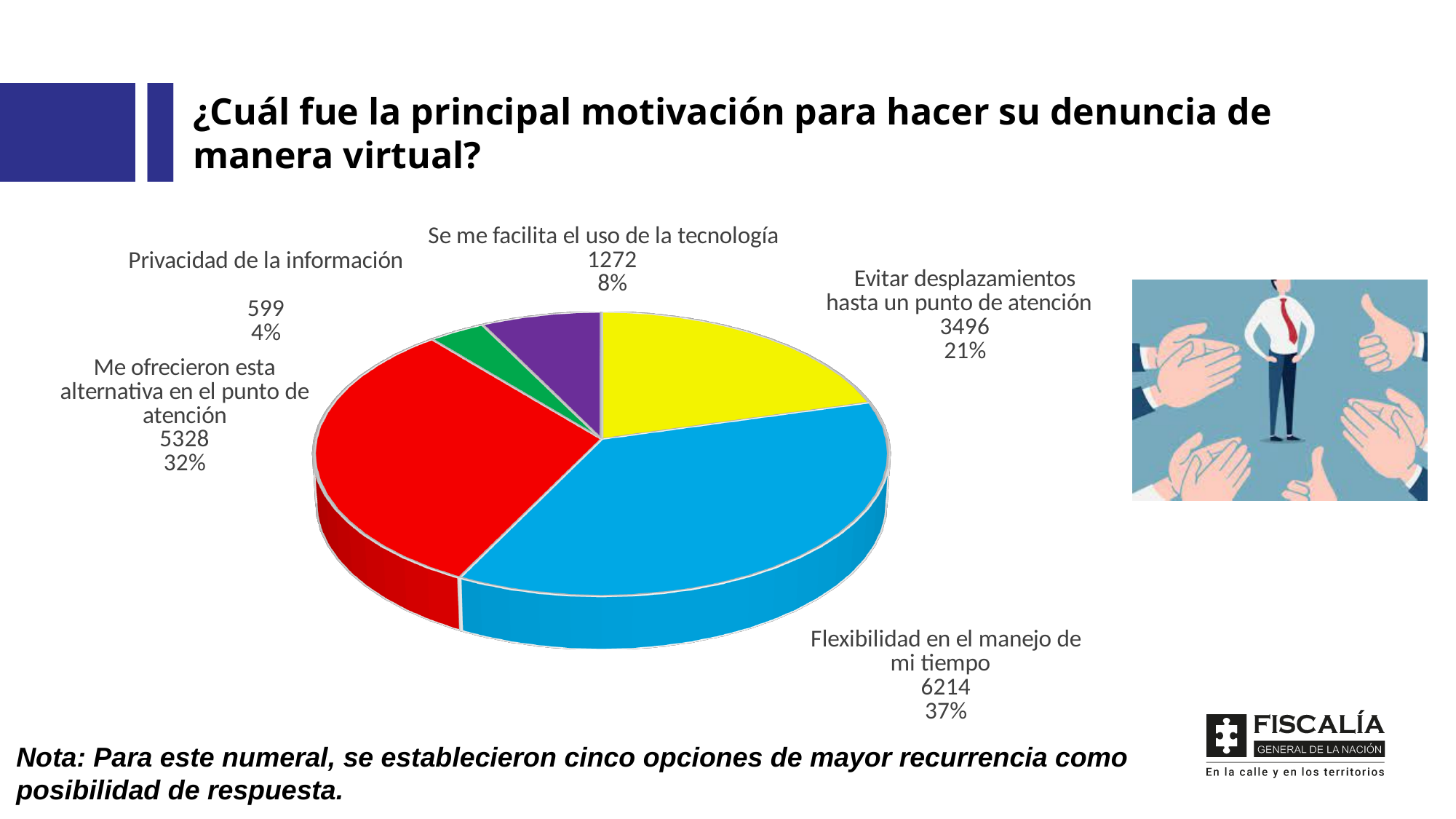
What colour is the slice for "Flexibilidad en el manejo de mi tiempo"? Blue What is the difference between the values for "Se me facilita el uso de la tecnología" and "Privacidad de la información"? 673 Which is larger: the value for "Evitar desplazamientos hasta un punto de atención" or "Se me facilita el uso de la tecnología"? Evitar desplazamientos hasta un punto de atención How many slices does the pie chart have? 5 What percentage share does "Evitar desplazamientos hasta un punto de atención" have? 21% Which category has the lowest value? Privacidad de la información Which category has the highest value? Flexibilidad en el manejo de mi tiempo What is the difference between the values for "Flexibilidad en el manejo de mi tiempo" and "Me ofrecieron esta alternativa en el punto de atención"? 886 What kind of chart is shown on the slide? Pie chart What is the value for "Me ofrecieron esta alternativa en el punto de atención"? 5328 What is the value for "Flexibilidad en el manejo de mi tiempo"? 6214 What percentage share does "Se me facilita el uso de la tecnología" have? 8%